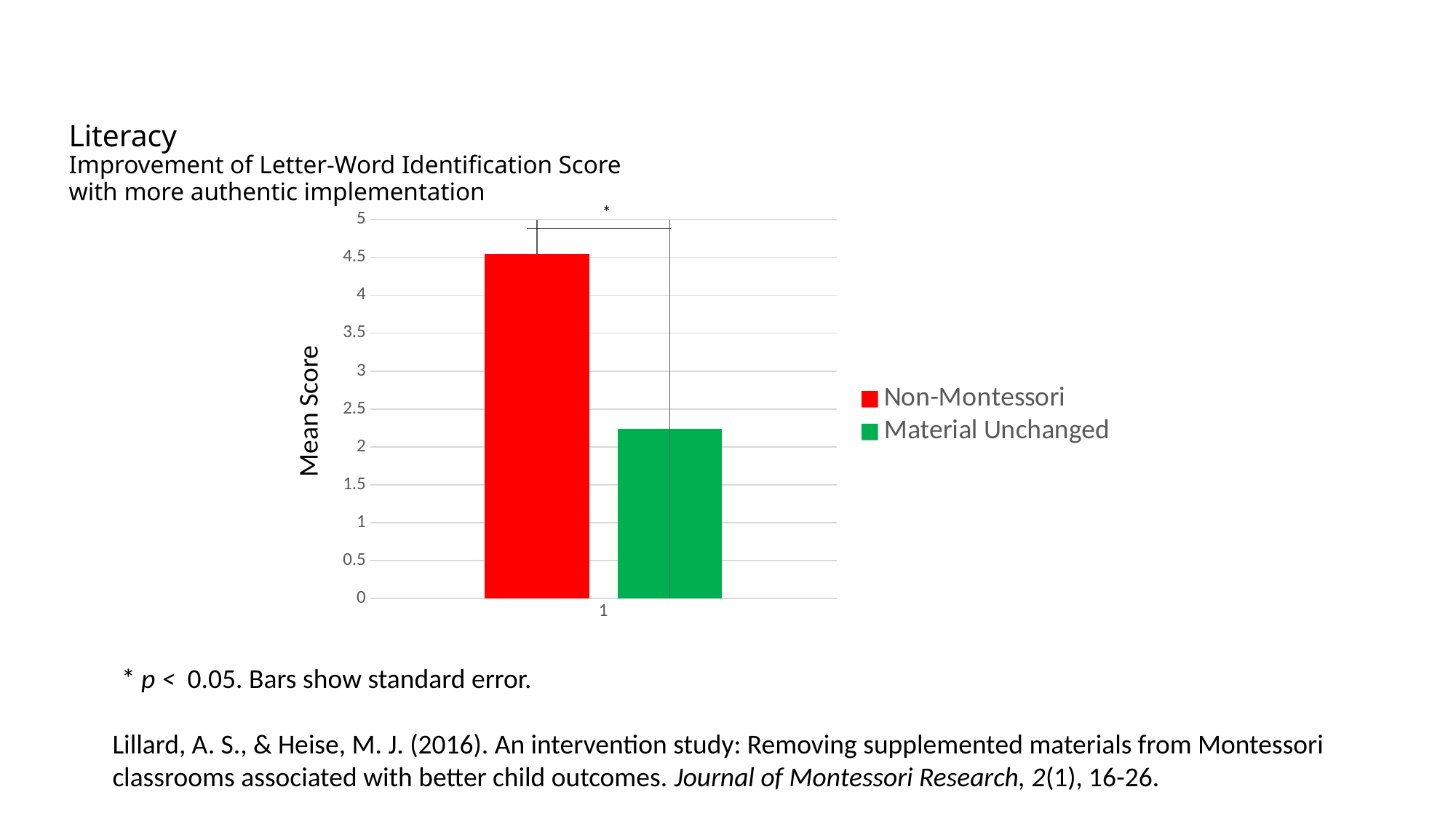
What colour is the bar for Material Unchanged? green Which is larger, the mean score for Non-Montessori or for Material Unchanged? Non-Montessori Is the mean score for Non-Montessori greater or less than 4? greater Is the mean score for Material Unchanged greater or less than 3? less Is the mean score for Material Unchanged greater or less than 2.5? less What kind of chart is shown on the slide? bar chart What is the label on the vertical axis? Mean Score Which series has the higher mean score? Non-Montessori What is the highest value shown on the vertical axis? 5 How many series does the legend list? 2 Which series has the lower mean score? Material Unchanged